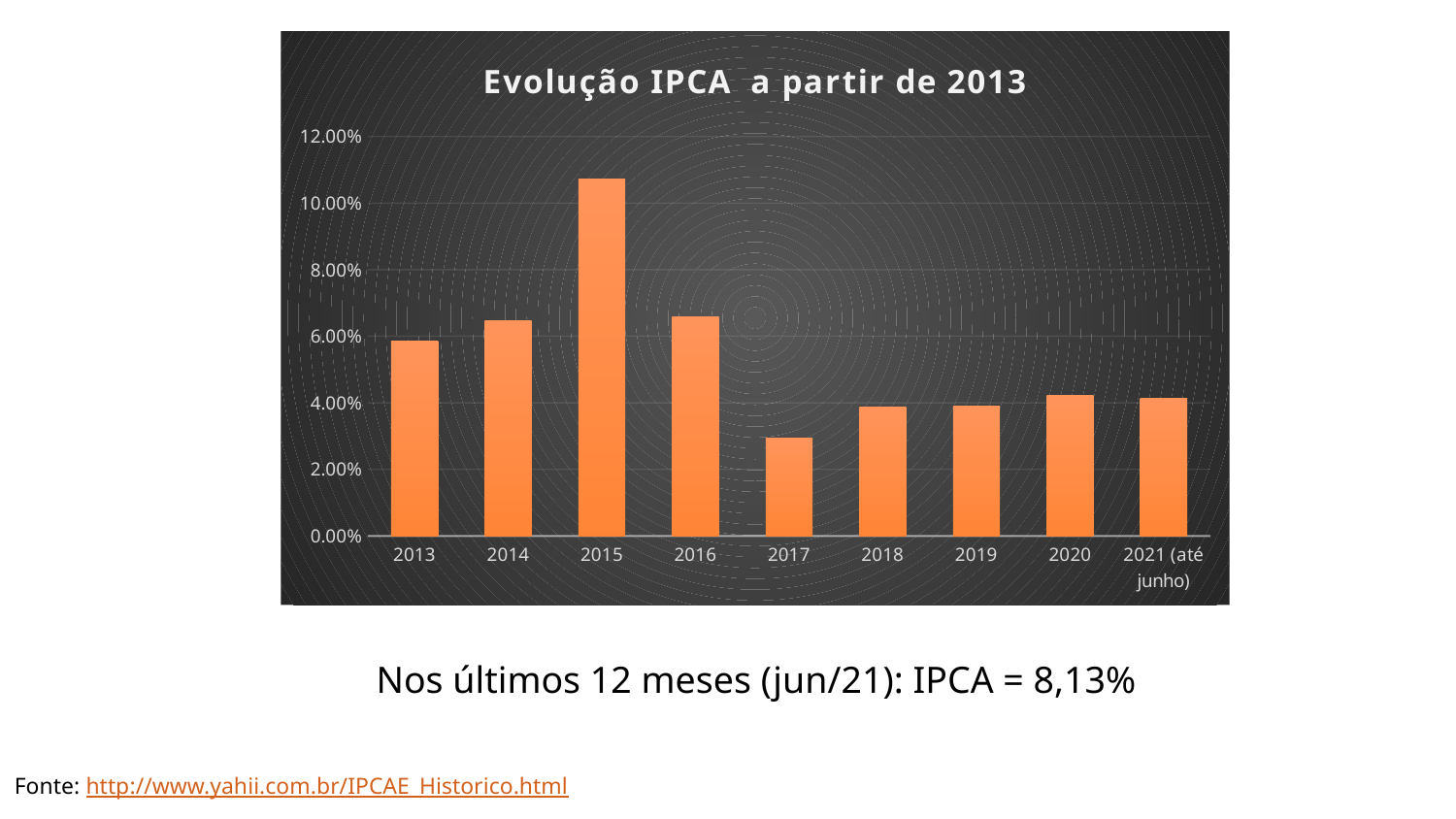
Which year has the lowest IPCA value? 2017 How many years (categories) are plotted on the x axis? 9 Which year has the highest IPCA value? 2015 Is the value for 2013 greater or less than 4.00%? greater Which year has the larger value, 2017 or 2018? 2018 Is the value for 2017 greater or less than 4.00%? less Which year has the larger value, 2015 or 2013? 2015 What type of chart is shown on the slide? bar chart What is the title of the chart? Evolução IPCA a partir de 2013 Do the values rise or fall from 2015 to 2017? fall Is the value for 2015 greater or less than 10.00%? greater